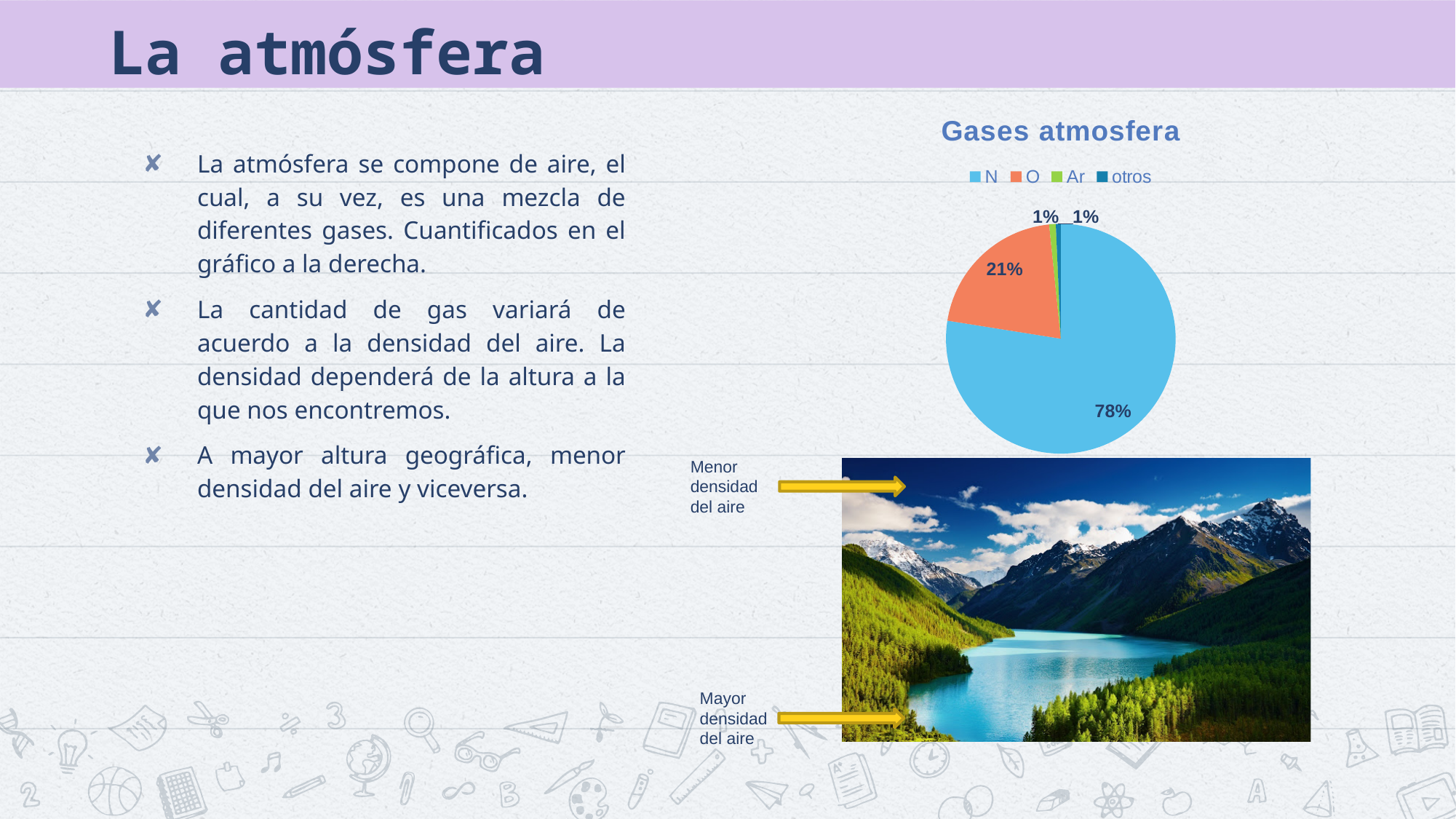
How many slices does the pie chart have? 4 What share of the pie does O represent? 21% What kind of chart is shown on the slide? pie chart What is the title of the chart? Gases atmosfera What share of the pie does 'otros' represent? 1% What is the difference between the share for N and the share for O? 57% Which legend entry is shown in orange? O Which gas has the largest slice of the pie? N What share of the pie does N represent? 78% How many entries does the chart legend list? 4 Which is larger, the slice for N or the slice for O? N